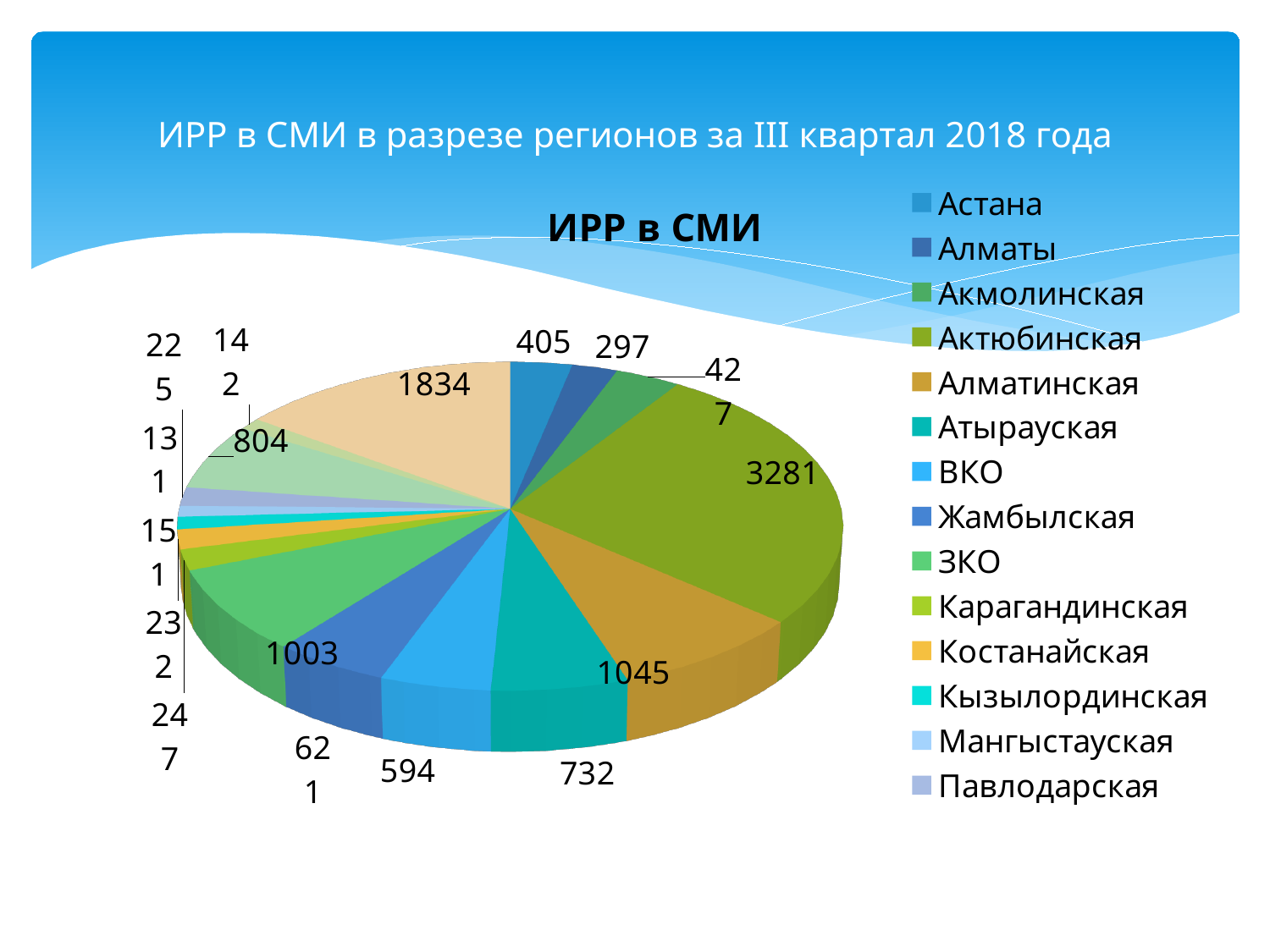
How many entries does the chart legend list? 14 What kind of chart is shown on the slide? pie chart What is the difference between the values for Актюбинская and Алматинская? 2236 What is the value for Астана? 405 Which is larger, the value for Атырауская or the value for ВКО? Атырауская What is the value for ЗКО? 1003 What is the value for Алматинская? 1045 Which region has the largest slice in the pie chart? Актюбинская What is the value for Актюбинская? 3281 What is the value for Атырауская? 732 What is the title of the chart? ИРР в СМИ What is the value for ВКО? 594